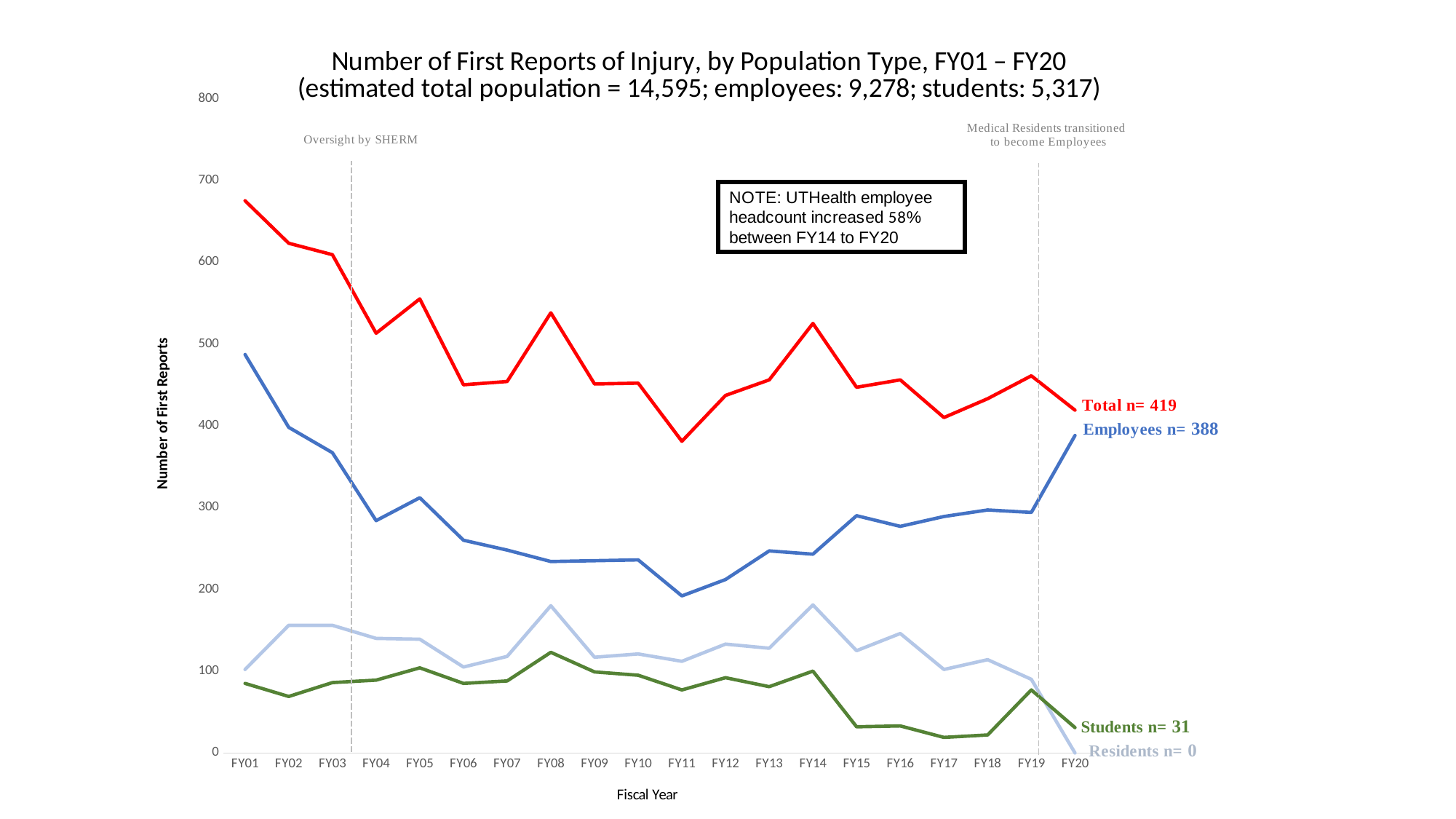
Is the Total number of first reports in FY01 greater or less than 600? greater What kind of chart is shown on the slide? line chart What is the label on the y axis? Number of First Reports In FY20, what is the difference between the Total and the Employees number of first reports? 31 What is the number of first reports for Employees in FY20? 388 How many fiscal years are plotted along the x axis? 20 Does the Employees line rise or fall from FY19 to FY20? rise Which fiscal year has the highest Total number of first reports? FY01 What is the number of first reports for Students in FY20? 31 What is the Total number of first reports in FY20? 419 How many series (lines) are plotted on the chart? 4 What is the number of first reports for Residents in FY20? 0